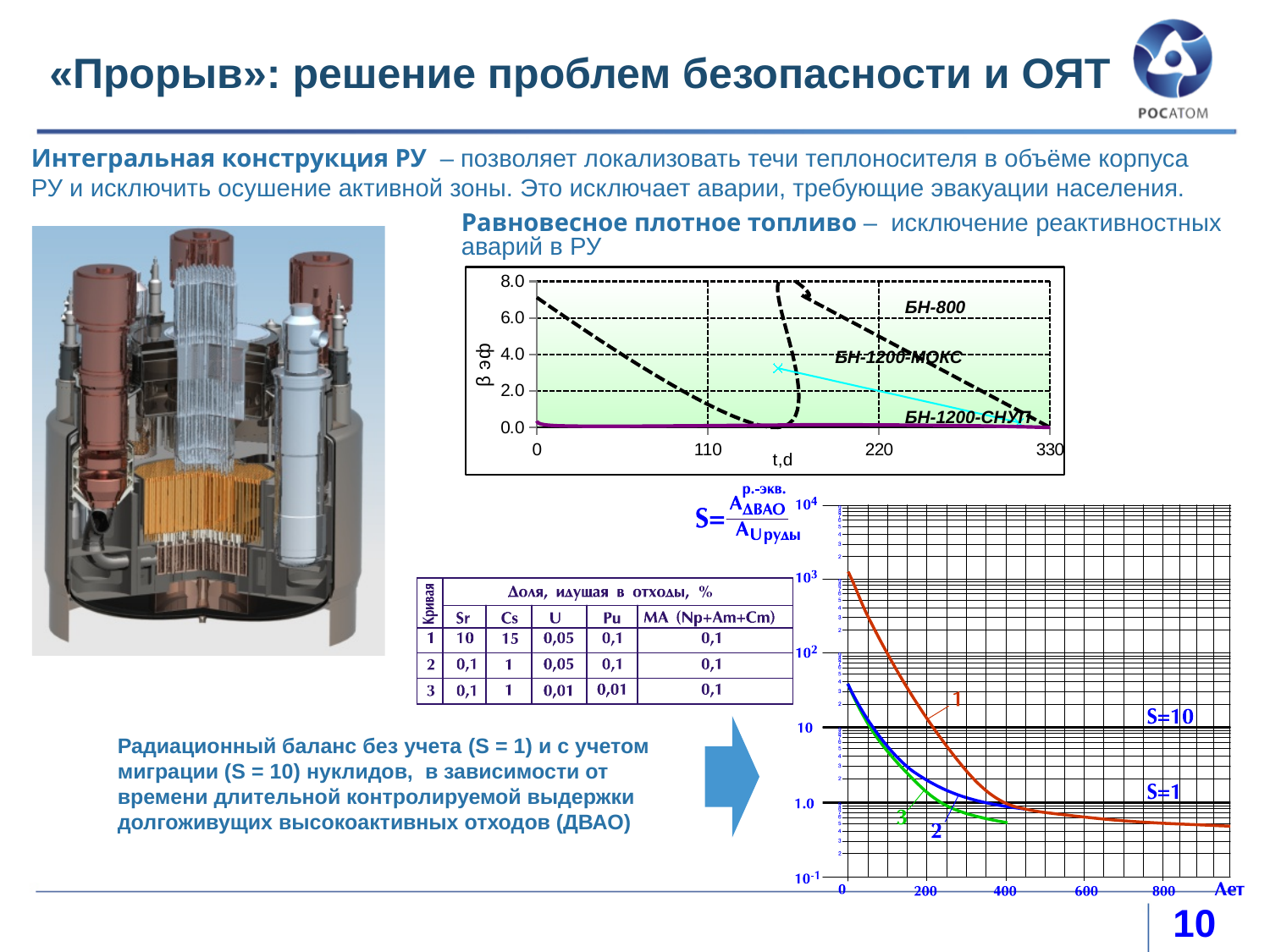
On the upper chart, is the value of the БН-1200-СНУП curve at t = 110 greater or less than 2.0? less On the lower chart, do the curves rise or fall as the number of years increases? fall On the upper chart, does the БН-800 curve rise or fall as t increases? fall On the lower chart, is the value of curve 1 at 100 years greater or less than 10? greater On the upper chart (β эф vs t,d), what kind of chart is it? line chart On the upper chart, what is the label of the x axis? t,d On the lower chart, is the value of curve 2 at 400 years greater or less than 1.0? less On the lower chart (radiation balance vs years), what is the label of the x axis? Лет On the upper chart, what is the highest value shown on the y axis? 8.0 On the upper chart, how many labelled reactor curves are shown? 3 On the lower chart, which numbered curve is the highest? 1 On the lower chart, which of the two horizontal reference lines is higher, S=10 or S=1? S=10